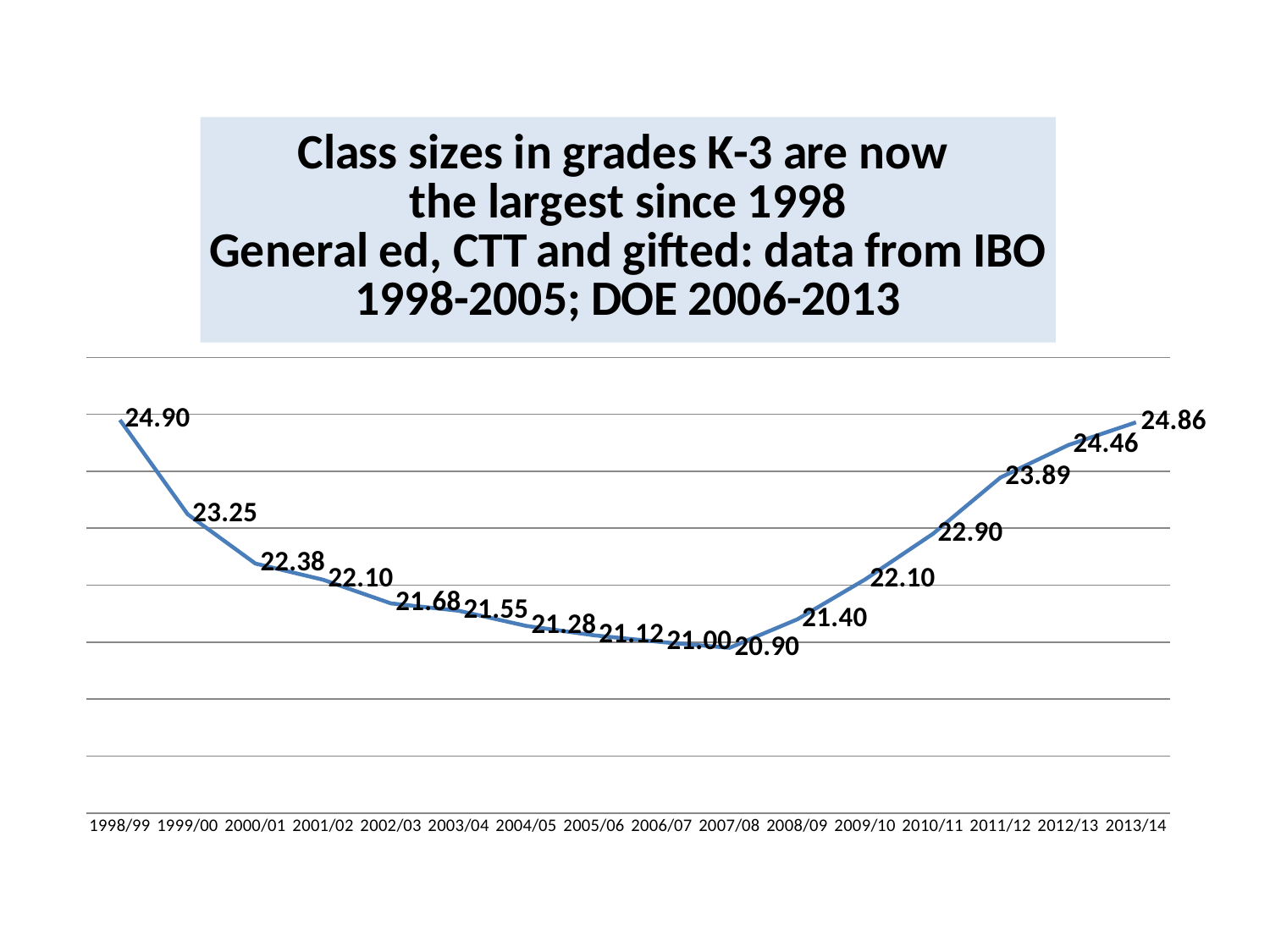
Which school year has the highest class size value? 1998/99 Which school year has the lowest class size value? 2007/08 What type of chart is shown on the slide? line chart Which is larger, the class size value for 1999/00 or for 2012/13? 2012/13 What is the class size value for 2007/08? 20.90 What is the difference between the class size values for 1998/99 and 2007/08? 4.00 How many school years are plotted on the chart? 16 What is the class size value for 1998/99? 24.90 Do the class size values rise or fall from 2007/08 to 2013/14? rise What is the class size value for 2011/12? 23.89 What is the class size value for 2013/14? 24.86 What is the difference between the class size values for 2013/14 and 2012/13? 0.40